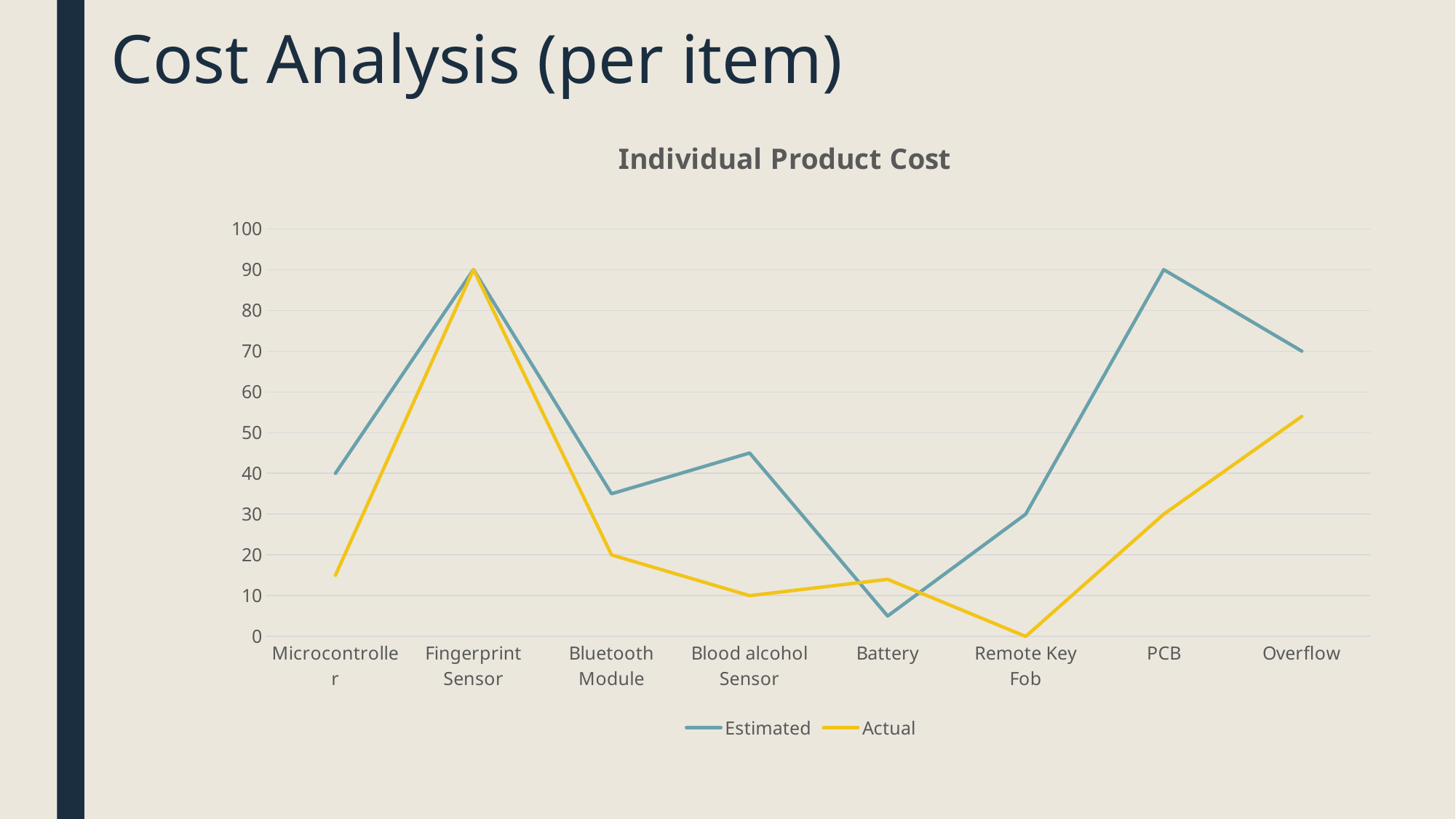
How many categories are shown on the x axis? 8 What is the Estimated value for Microcontroller? 40 Is the Actual value for Overflow greater or less than 50? greater What is the difference between the Estimated values for PCB and Overflow? 20 What is the Estimated value for PCB? 90 For Microcontroller, which is larger, the Estimated or the Actual value? Estimated What is the Actual value for Remote Key Fob? 0 How many series does the legend list? 2 Which category has the lowest Estimated value? Battery Which category has the highest Actual value? Fingerprint Sensor What is the Actual value for Blood alcohol Sensor? 10 What kind of chart is shown on the slide? line chart